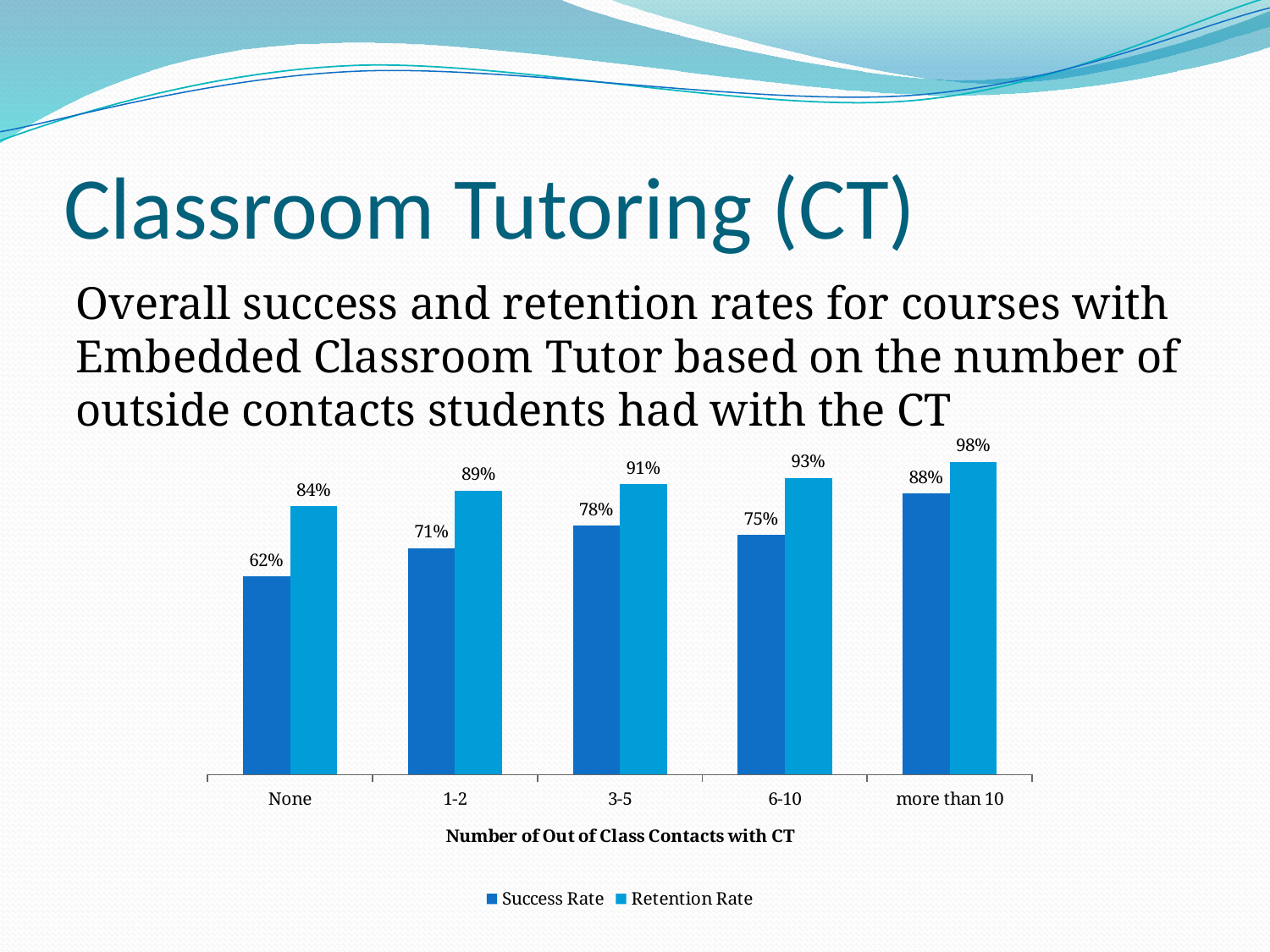
Which category has the lowest Success Rate? None How many categories are shown on the x axis? 5 What is the difference between the Retention Rate and the Success Rate for the '1-2' category? 18% What is the x axis title of the chart? Number of Out of Class Contacts with CT What is the Success Rate for the 'None' category? 62% What is the Success Rate for the '3-5' category? 78% How many series does the legend list? 2 What kind of chart is shown on the slide? Bar chart Which category has the highest Retention Rate? more than 10 Does the Retention Rate rise or fall as the number of out of class contacts increases along the x axis? Rises Which is larger, the Success Rate for '6-10' or the Success Rate for '3-5'? Success Rate for 3-5 What is the Retention Rate for the '6-10' category? 93%